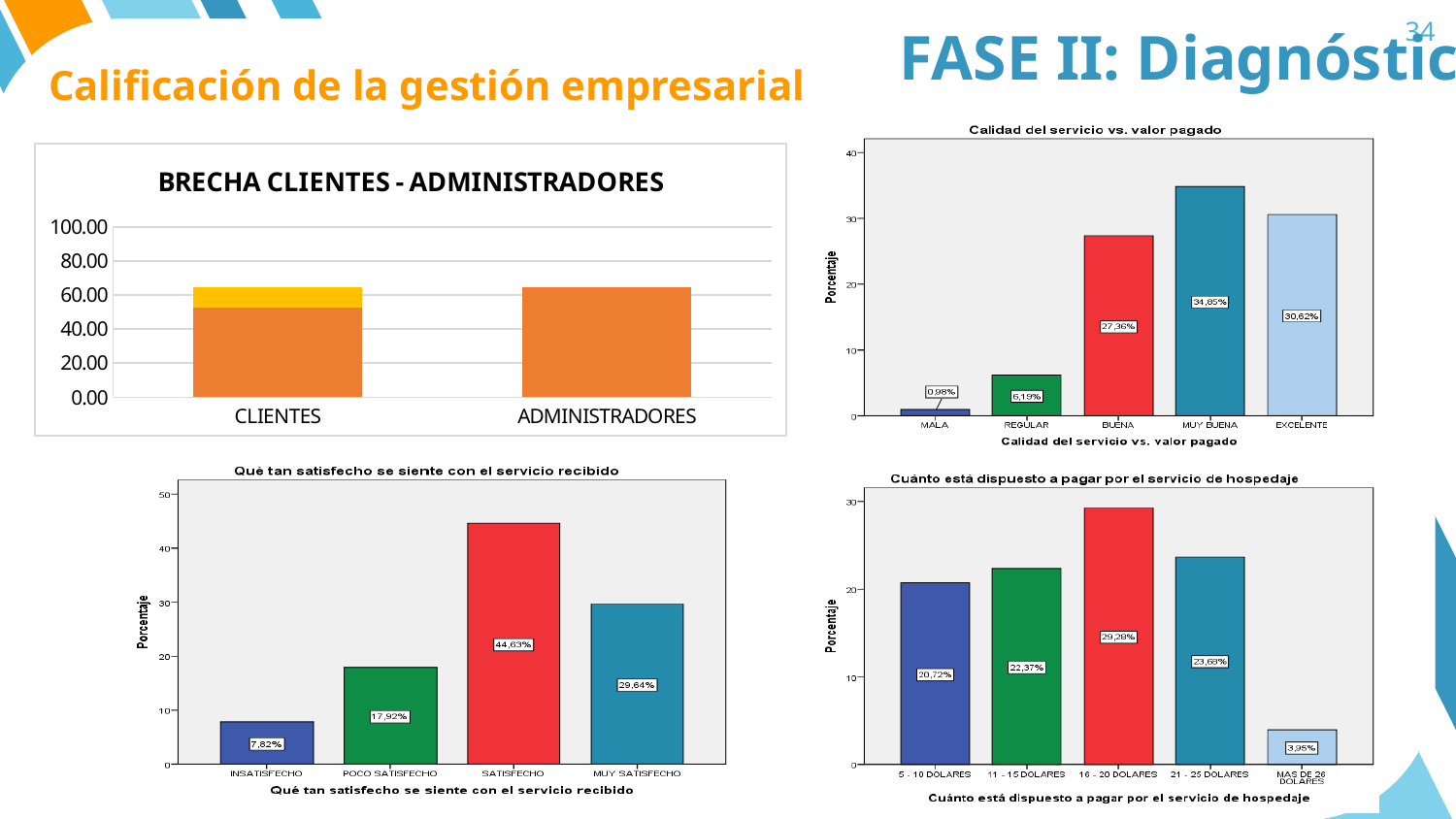
In the chart 'BRECHA CLIENTES - ADMINISTRADORES', is the value for ADMINISTRADORES greater or less than 80.00? less In the chart 'Qué tan satisfecho se siente con el servicio recibido', how many categories are shown on the x axis? 4 How many charts are shown on the slide? 4 In the chart 'Cuánto está dispuesto a pagar por el servicio de hospedaje', what is the value for MAS DE 26 DOLARES? 3,95% In the chart 'Qué tan satisfecho se siente con el servicio recibido', what is the value for POCO SATISFECHO? 17,92% What kind of chart is 'BRECHA CLIENTES - ADMINISTRADORES'? bar chart In the chart 'Calidad del servicio vs. valor pagado', which category has the lowest value? MALA In the chart 'Qué tan satisfecho se siente con el servicio recibido', which category has the highest value? SATISFECHO In the chart 'Cuánto está dispuesto a pagar por el servicio de hospedaje', what is the value for 16 - 20 DOLARES? 29,28% In the chart 'Calidad del servicio vs. valor pagado', what is the value for MUY BUENA? 34,85% In the chart 'Cuánto está dispuesto a pagar por el servicio de hospedaje', which is larger, the value for 11 - 15 DOLARES or the value for 21 - 25 DOLARES? 21 - 25 DOLARES In the chart 'Calidad del servicio vs. valor pagado', what is the difference between the values for MUY BUENA and EXCELENTE? 4,23%